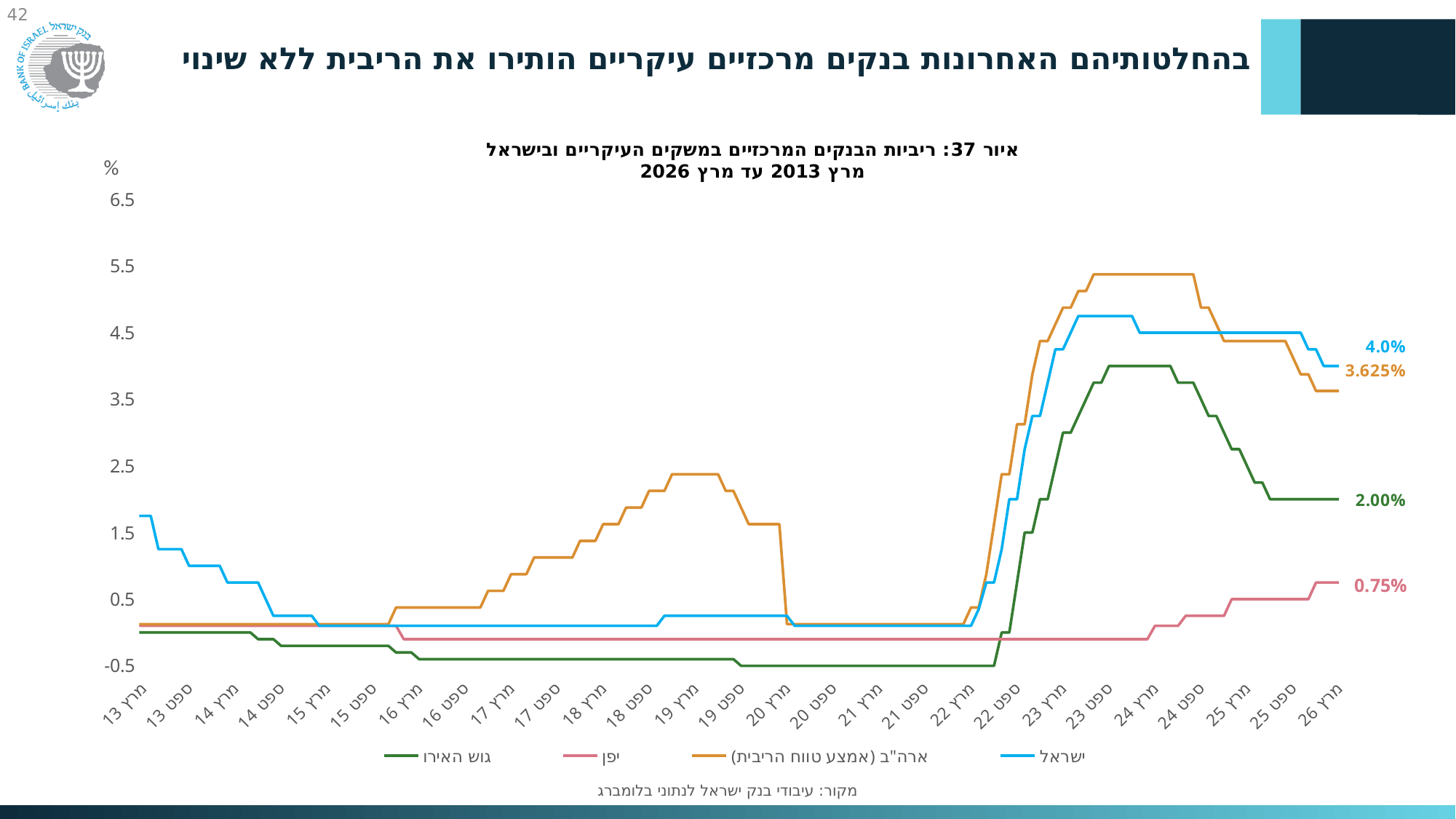
What is the difference between the latest values of ישראל and גוש האירו? 2.0% What is the source stated below the chart? עיבודי בנק ישראל לנתוני בלומברג Is the peak value of the ארה"ב series (around late 2023) greater or less than 5? greater How many series does the legend list? 4 What is the latest value shown for ישראל (Israel) at the right end of the chart? 4.0% Does the יפן series rise or fall over the last part of the chart (from 2024 to 2026)? Rises What is the latest value shown for יפן (Japan) at the right end of the chart? 0.75% Which series has the highest value at the right end of the chart (March 2026)? ישראל What type of chart is shown on the slide? Line chart What is the latest value shown for גוש האירו (Euro area) at the right end of the chart? 2.00% Which series has the lowest value at the right end of the chart (March 2026)? יפן What is the latest value shown for ארה"ב (אמצע טווח הריבית) at the right end of the chart? 3.625%